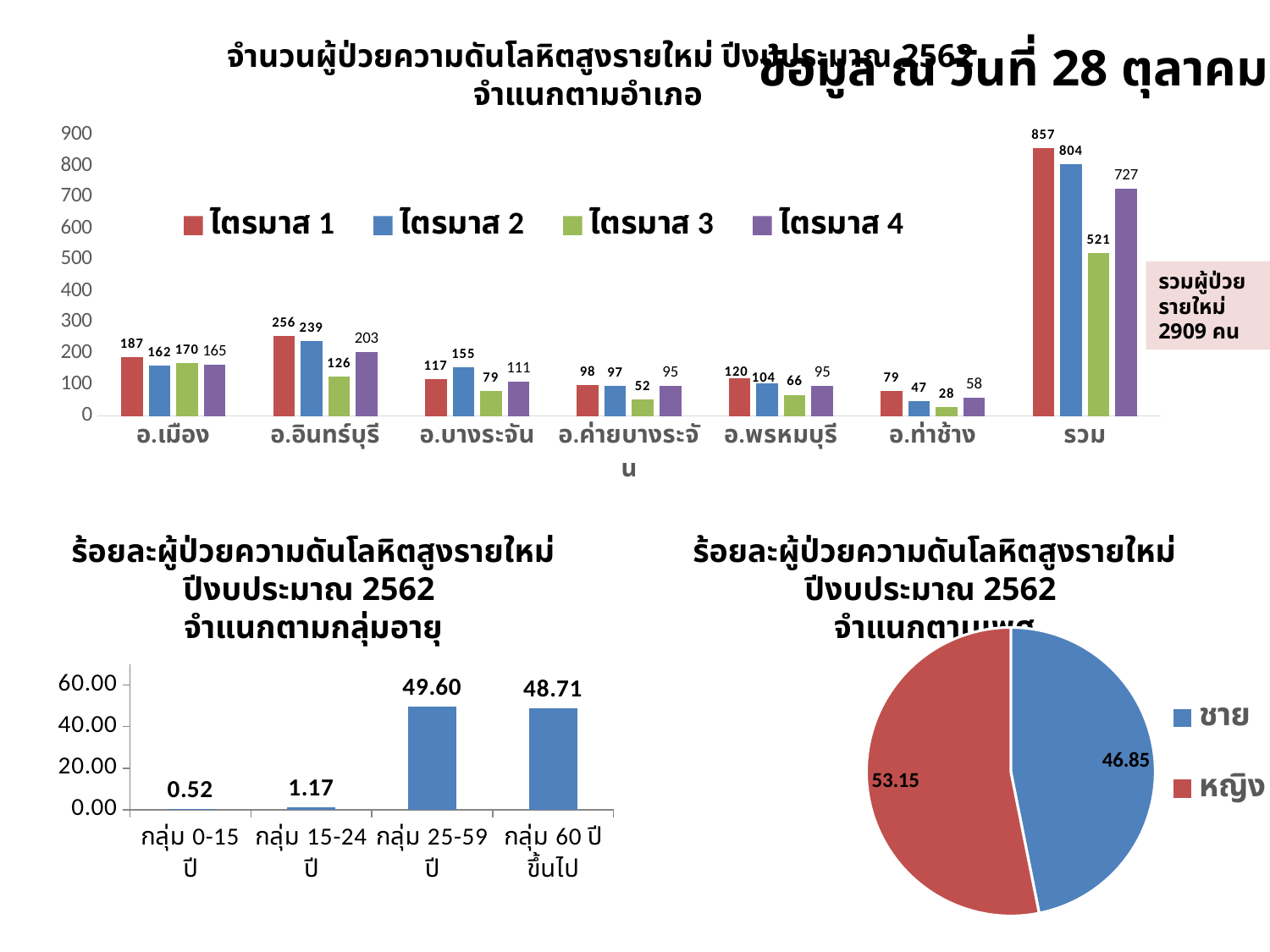
In the top chart (by district), what is the value for ไตรมาส 1 in อ.อินทร์บุรี? 256 In the top chart (by district), what is the value for ไตรมาส 3 in อ.ท่าช้าง? 28 In the bottom-left chart (by age group), what kind of chart is it? bar chart In the top chart (by district), what is the difference between ไตรมาส 1 and ไตรมาส 2 for รวม? 53 In the top chart (by district), how many categories are shown on the x axis? 7 In the top chart (by district), which quarter has the lowest value for รวม? ไตรมาส 3 In the bottom-left chart (by age group), what is the value for กลุ่ม 25-59 ปี? 49.60 In the bottom-right pie chart (by sex), what is the share for หญิง? 53.15 In the top chart (by district), how many series does the legend list? 4 In the bottom-left chart (by age group), which age group has the lowest value? กลุ่ม 0-15 ปี In the bottom-right pie chart (by sex), which slice is larger: ชาย or หญิง? หญิง In the top chart (by district), which is larger for อ.บางระจัน: ไตรมาส 1 or ไตรมาส 2? ไตรมาส 2